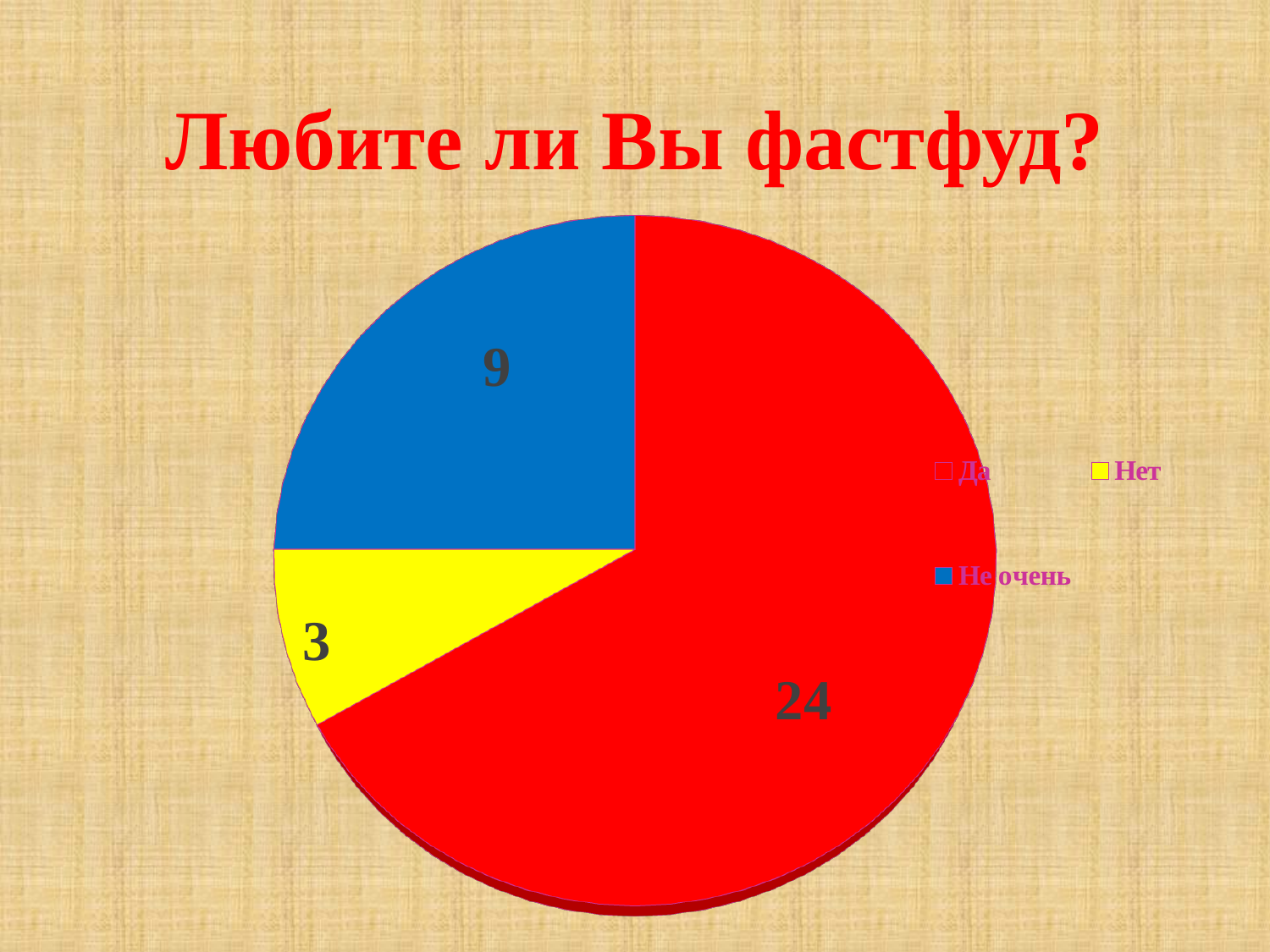
How many entries does the legend list? 3 What share of the pie does the "Не очень" slice represent? 25% What is the title of the chart? Любите ли Вы фастфуд? Which category has the smallest slice? Нет Which category has the largest slice? Да What is the value for "Да"? 24 What is the value for "Не очень"? 9 What is the difference between the values for "Да" and "Не очень"? 15 What is the value for "Нет"? 3 What kind of chart is shown on the slide? pie chart How many slices does the pie chart have? 3 Which is larger, the value for "Не очень" or the value for "Нет"? Не очень